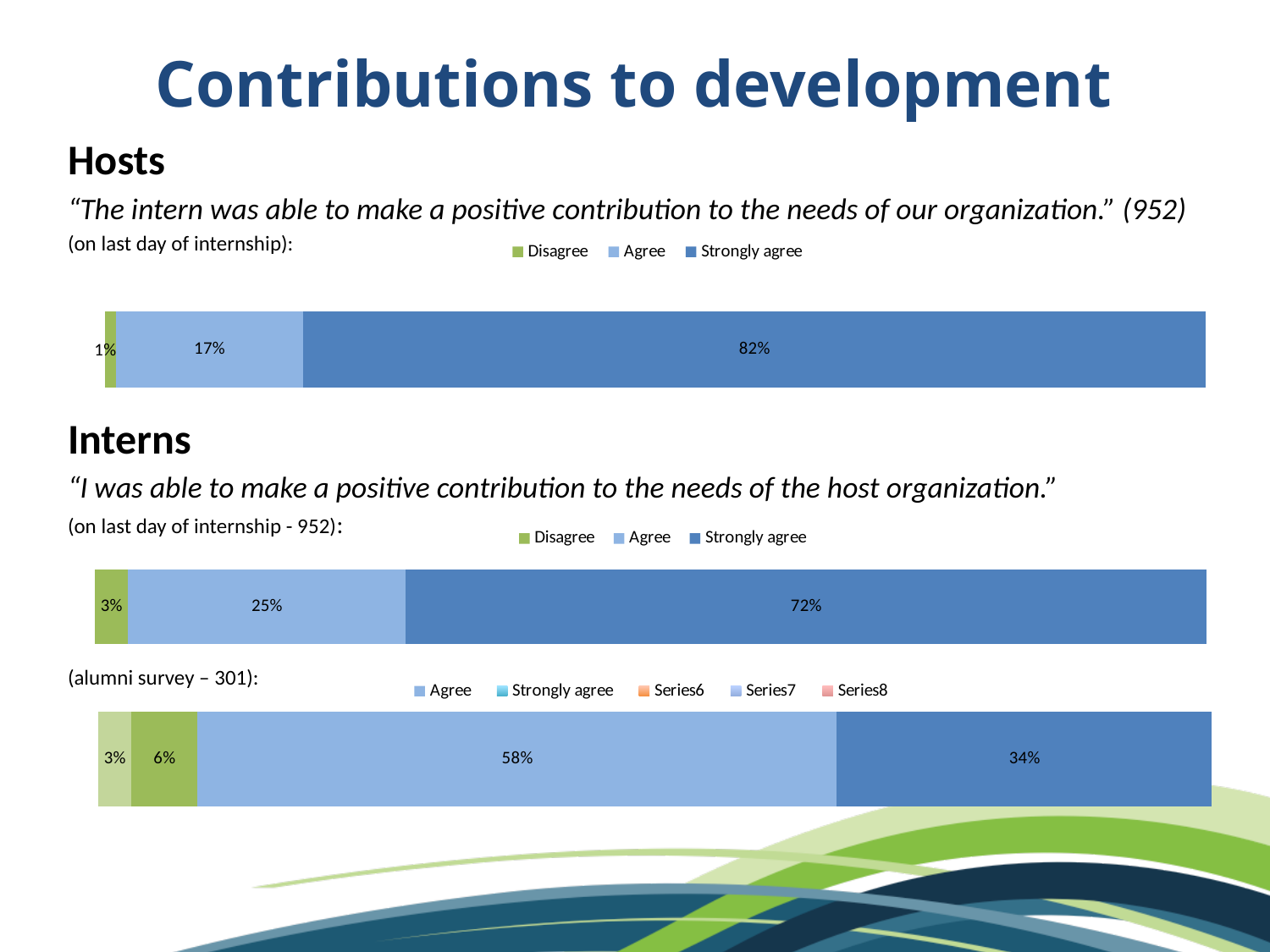
What type of chart is used for the Hosts data? Stacked bar chart In the Interns chart for the last day of internship, what is the difference between the Strongly agree and Agree percentages? 47% In the Hosts chart, which response category has the largest share? Strongly agree In the Interns chart for the last day of internship, what percentage of interns disagree? 3% In the Interns chart for the last day of internship, what percentage of interns strongly agree? 72% In the Hosts chart, what percentage of hosts disagree? 1% In the alumni survey chart at the bottom, what is the largest percentage shown on the bar? 58% In the Interns chart for the last day of internship, which is larger: Agree or Strongly agree? Strongly agree In the Hosts chart, what percentage of hosts agree? 17% How many segments does the bar in the alumni survey chart at the bottom have? 4 In the Hosts chart, what is the difference between the Strongly agree and Agree percentages? 65% In the Hosts chart, what percentage of hosts strongly agree that the intern made a positive contribution? 82%